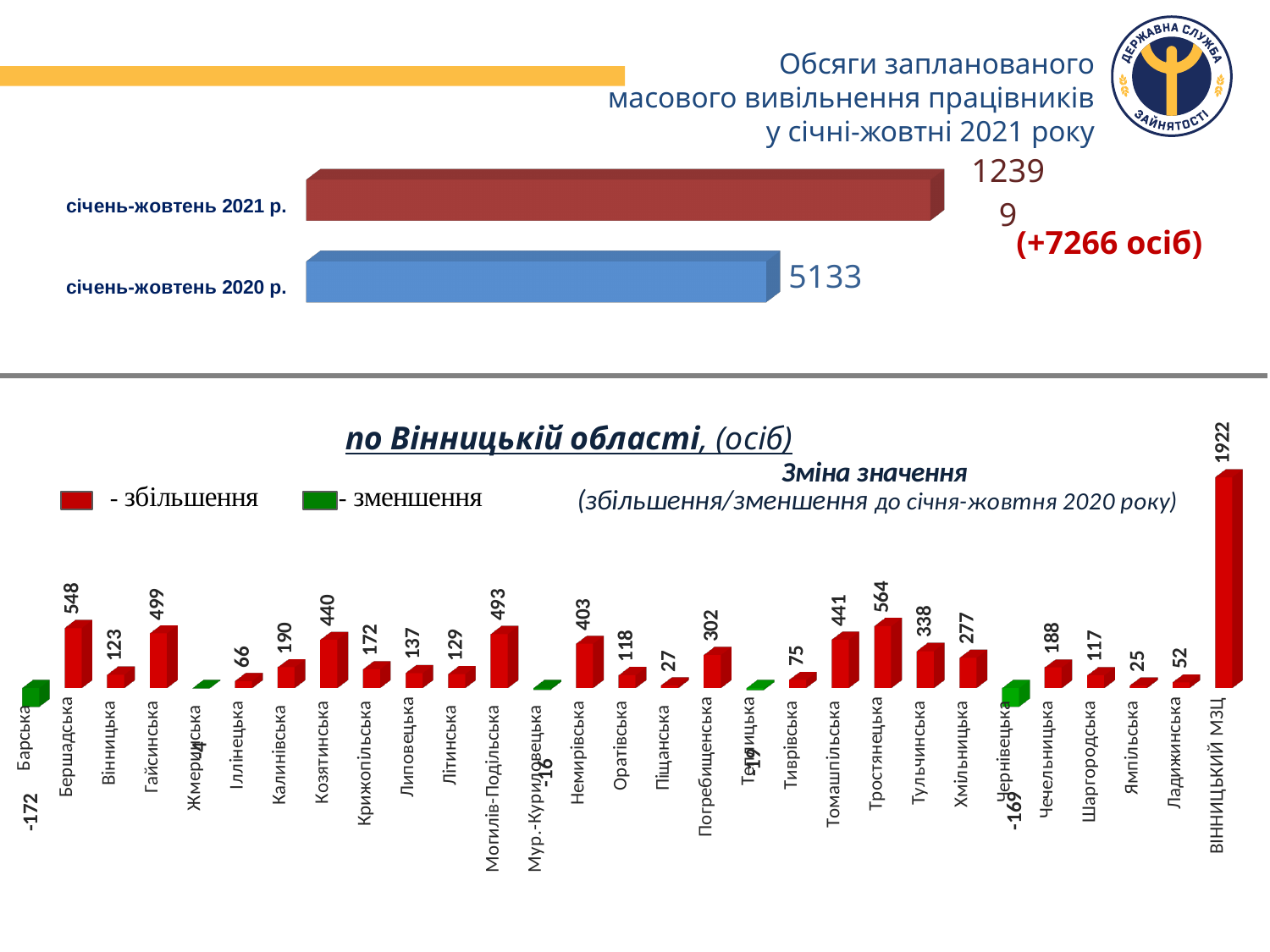
In the bottom chart (по Вінницькій області), what is the value for Тростянецька? 564 In the bottom chart (по Вінницькій області), what is the value for Барська? -172 How many categories are shown in the bottom chart (по Вінницькій області)? 29 In the bottom chart (по Вінницькій області), what is the difference between Немирівська and Оратівська? 285 In the bottom chart (по Вінницькій області), which category has the highest value? ВІННИЦЬКИЙ МЗЦ In the bottom chart (по Вінницькій області), which category has the lowest value? Барська In the top chart, what is the difference between the 2021 and 2020 values? 7266 In the bottom chart (по Вінницькій області), which is larger: Бершадська or Гайсинська? Бершадська In the bottom chart (по Вінницькій області), what colour are the bars representing a decrease (зменшення)? green In the top chart, what is the value for січень-жовтень 2020 р.? 5133 In the top chart, what is the value for січень-жовтень 2021 р.? 12399 What kind of chart is the top chart on the slide? bar chart